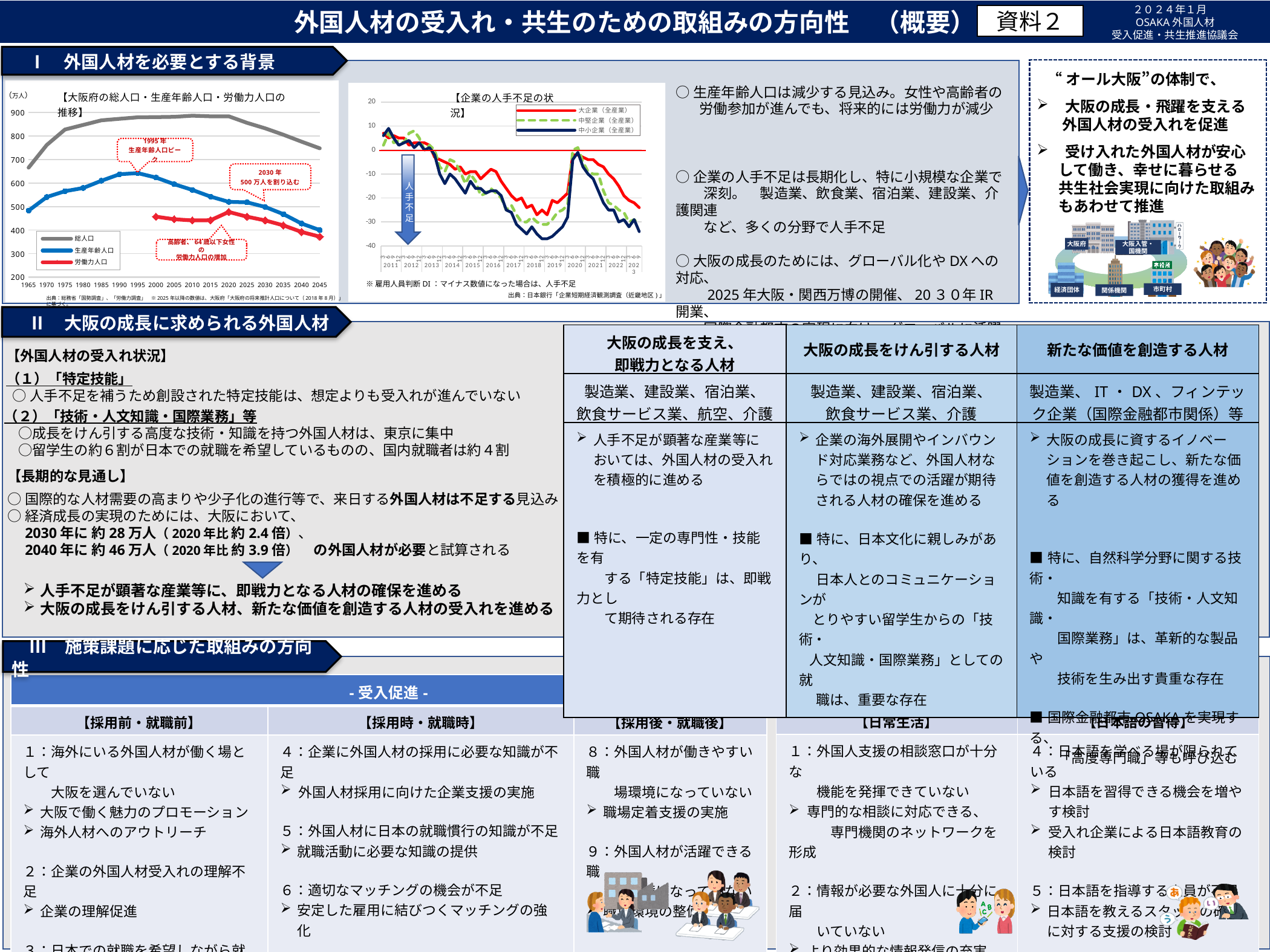
In the right chart 「企業の人手不足の状況」, which series has the lowest value in 2023? 中小企業（全産業） What kind of chart is the left chart titled 「大阪府の総人口・生産年齢人口・労働力人口の推移」? line chart In the left chart 「大阪府の総人口・生産年齢人口・労働力人口の推移」, is the value of 生産年齢人口 in 1965 greater or less than 500? less In the right chart 「企業の人手不足の状況」, is the value of 中小企業（全産業） in 2023 greater or less than -20? less How many series does the legend of the left chart 「大阪府の総人口・生産年齢人口・労働力人口の推移」 list? 3 In the left chart 「大阪府の総人口・生産年齢人口・労働力人口の推移」, what unit is shown at the top of the vertical axis? 万人 How many series does the legend of the right chart 「企業の人手不足の状況」 list? 3 What kind of chart is the right chart titled 「企業の人手不足の状況」? line chart In the left chart 「大阪府の総人口・生産年齢人口・労働力人口の推移」, is the value of 総人口 in 2045 greater or less than 800? less In the left chart 「大阪府の総人口・生産年齢人口・労働力人口の推移」, does the 生産年齢人口 series rise or fall from 1995 to 2045? fall In the left chart 「大阪府の総人口・生産年齢人口・労働力人口の推移」, which series has the lowest values across the whole period? 労働力人口 In the left chart 「大阪府の総人口・生産年齢人口・労働力人口の推移」, which series has the highest values across the whole period? 総人口